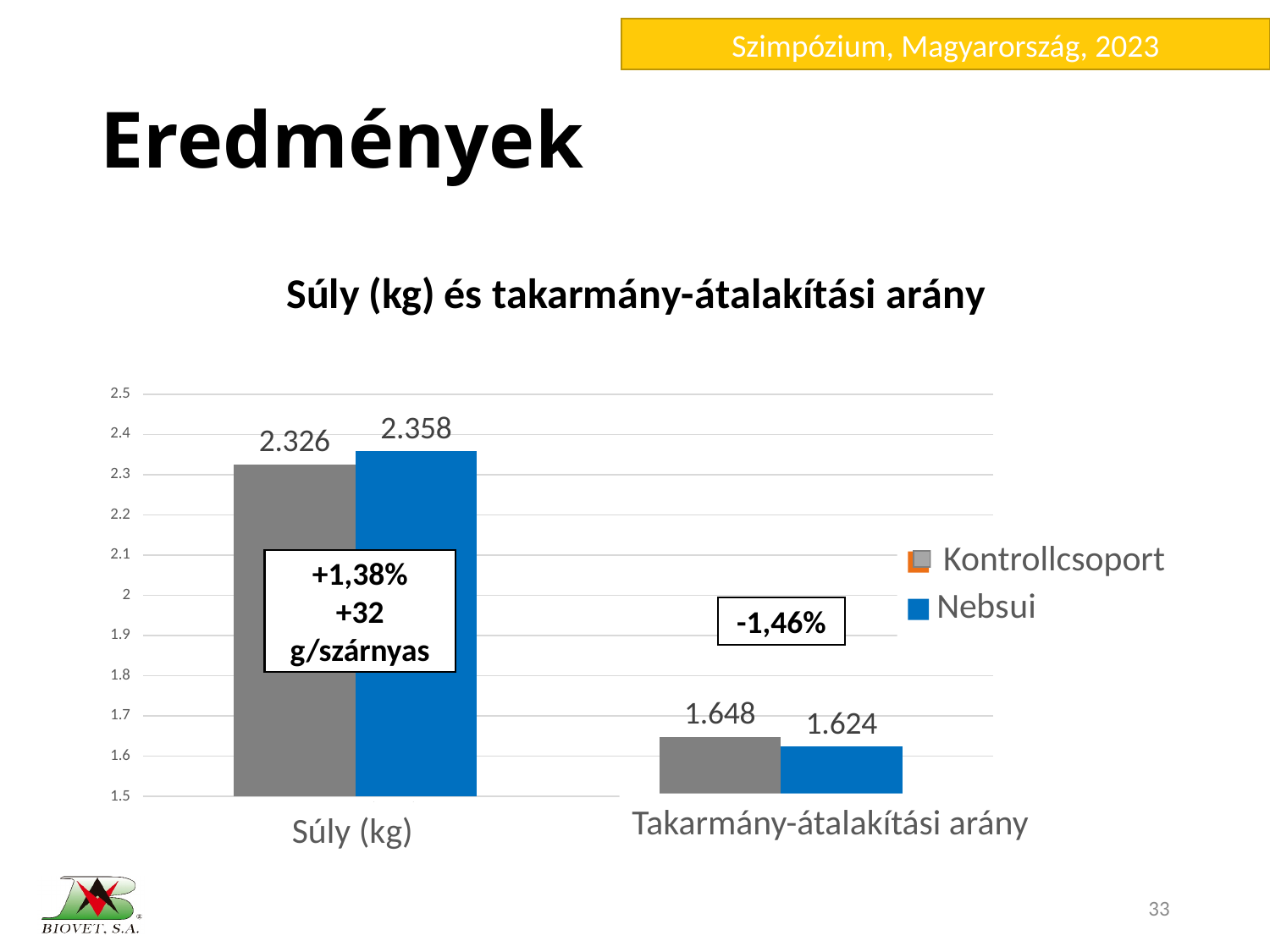
What is the value for Kontrollcsoport in the Takarmány-átalakítási arány category? 1.648 How many categories are shown on the x axis? 2 What is the difference between the Kontrollcsoport and Nebsui values in the Takarmány-átalakítási arány category? 0.024 Which series has the higher value in the Súly (kg) category? Nebsui What kind of chart is shown on the slide? Bar chart What is the difference between the Nebsui and Kontrollcsoport values in the Súly (kg) category? 0.032 Which series has the lower value in the Takarmány-átalakítási arány category? Nebsui What is the value for Nebsui in the Súly (kg) category? 2.358 What is the value for Kontrollcsoport in the Súly (kg) category? 2.326 What is the value for Nebsui in the Takarmány-átalakítási arány category? 1.624 What is the title of the chart? Súly (kg) és takarmány-átalakítási arány How many series does the legend list? 2